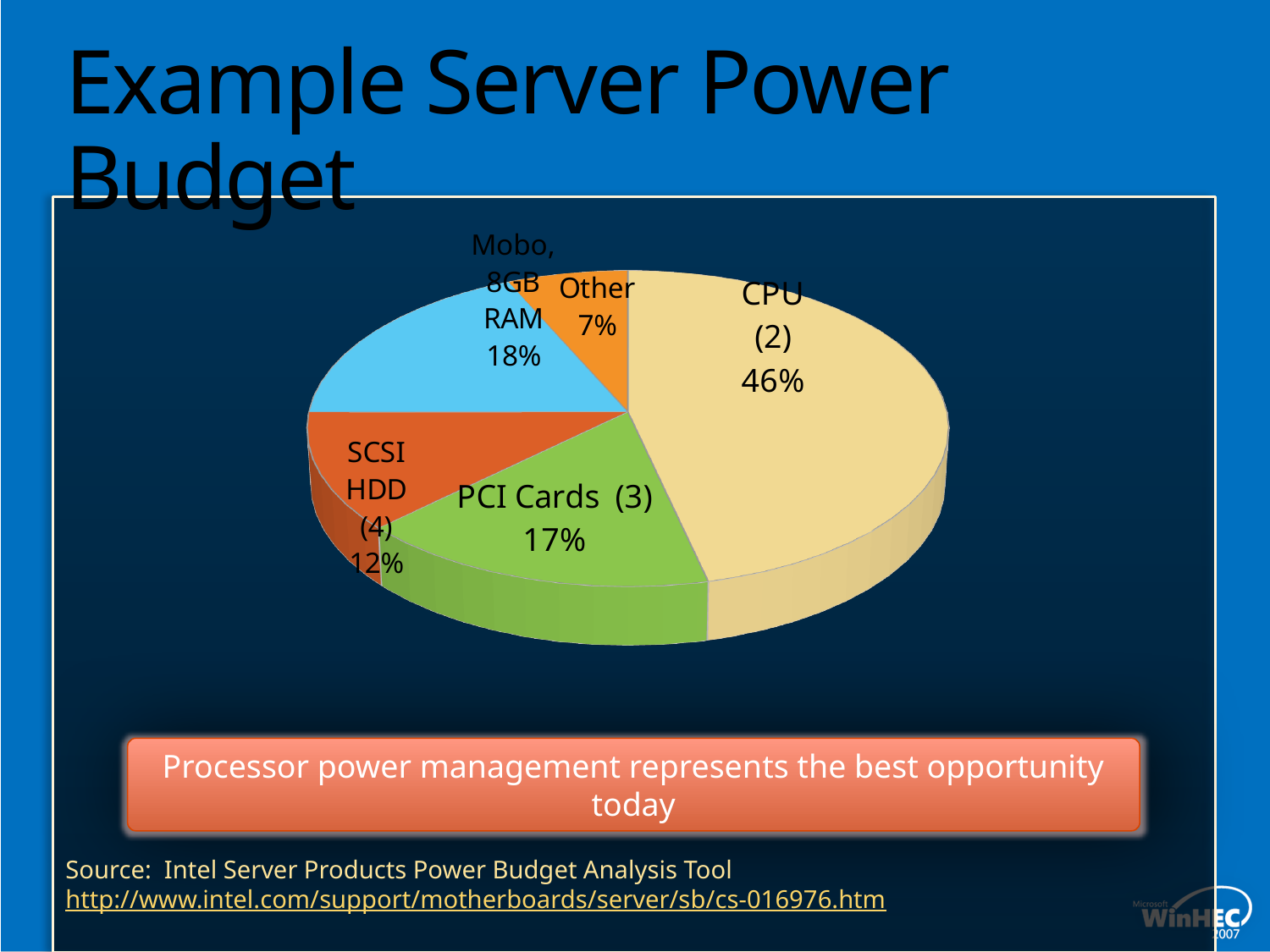
Which slice has the smallest share of the power budget? Other What is the difference in percentage points between CPU (2) and PCI Cards (3)? 29 Which is larger, the share for SCSI HDD (4) or the share for Other? SCSI HDD (4) What percentage is shown for the Other slice? 7% What percentage is shown for SCSI HDD (4)? 12% What share of the server power budget does CPU (2) account for? 46% What percentage is shown for Mobo, 8GB RAM? 18% What colour is the CPU (2) slice? beige/tan Which component has the largest share of the power budget? CPU (2) What kind of chart is shown on the slide? pie chart What percentage is shown for PCI Cards (3)? 17% How many slices does the pie chart have? 5